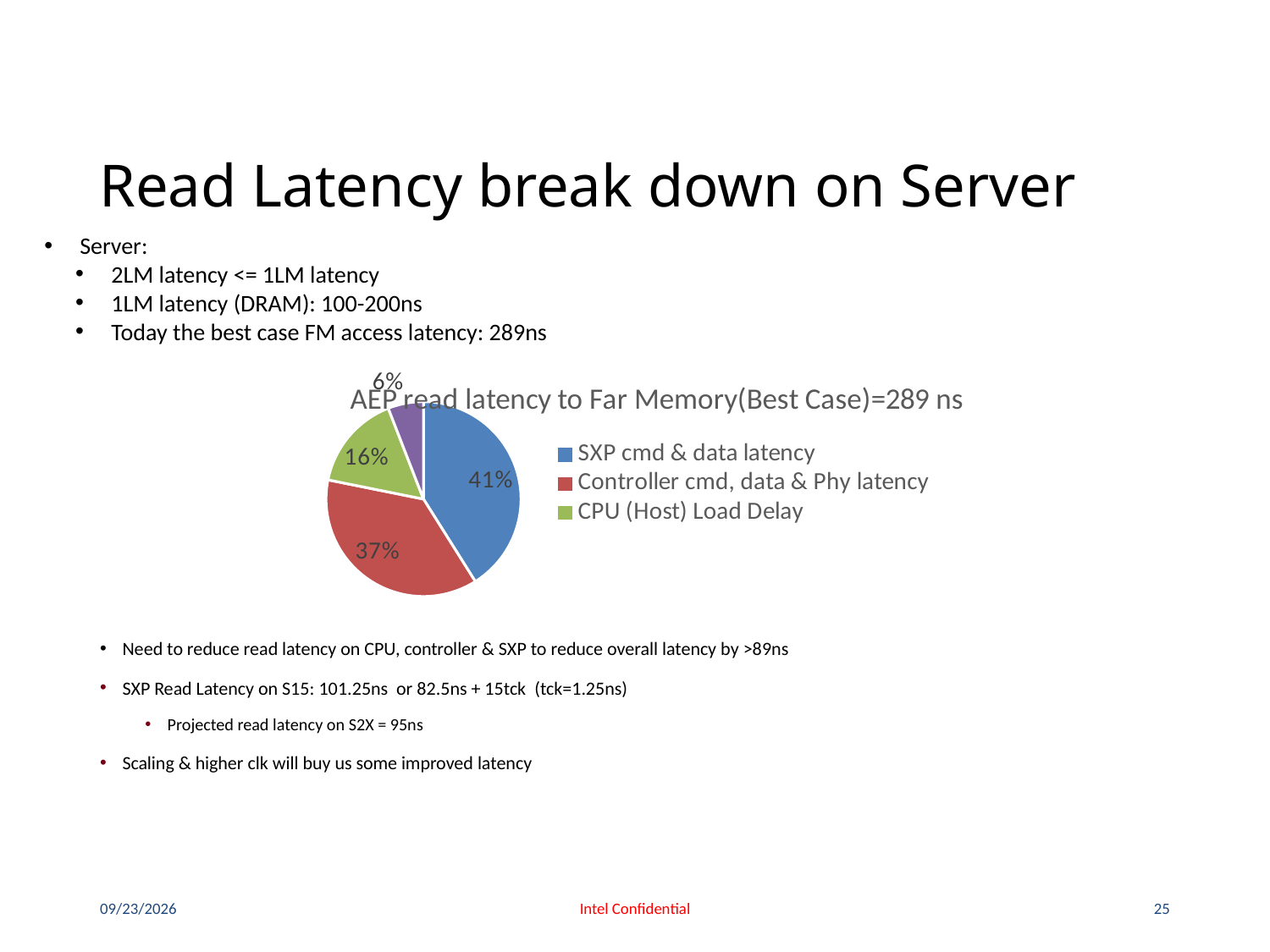
What is the title of the pie chart? AEP read latency to Far Memory(Best Case)=289 ns Which legend category has the largest slice of the pie? SXP cmd & data latency Which is larger: the SXP cmd & data latency slice or the CPU (Host) Load Delay slice? SXP cmd & data latency What share of the pie does SXP cmd & data latency account for? 41% What is the difference in percentage points between the SXP cmd & data latency slice and the Controller cmd, data & Phy latency slice? 4% What share of the pie does CPU (Host) Load Delay account for? 16% What share of the pie does Controller cmd, data & Phy latency account for? 37% What is the difference in percentage points between the Controller cmd, data & Phy latency slice and the CPU (Host) Load Delay slice? 21% What is the smallest percentage shown on the pie chart? 6% What type of chart is shown on the slide? pie chart How many entries does the chart legend list? 3 How many slices does the pie chart have? 4